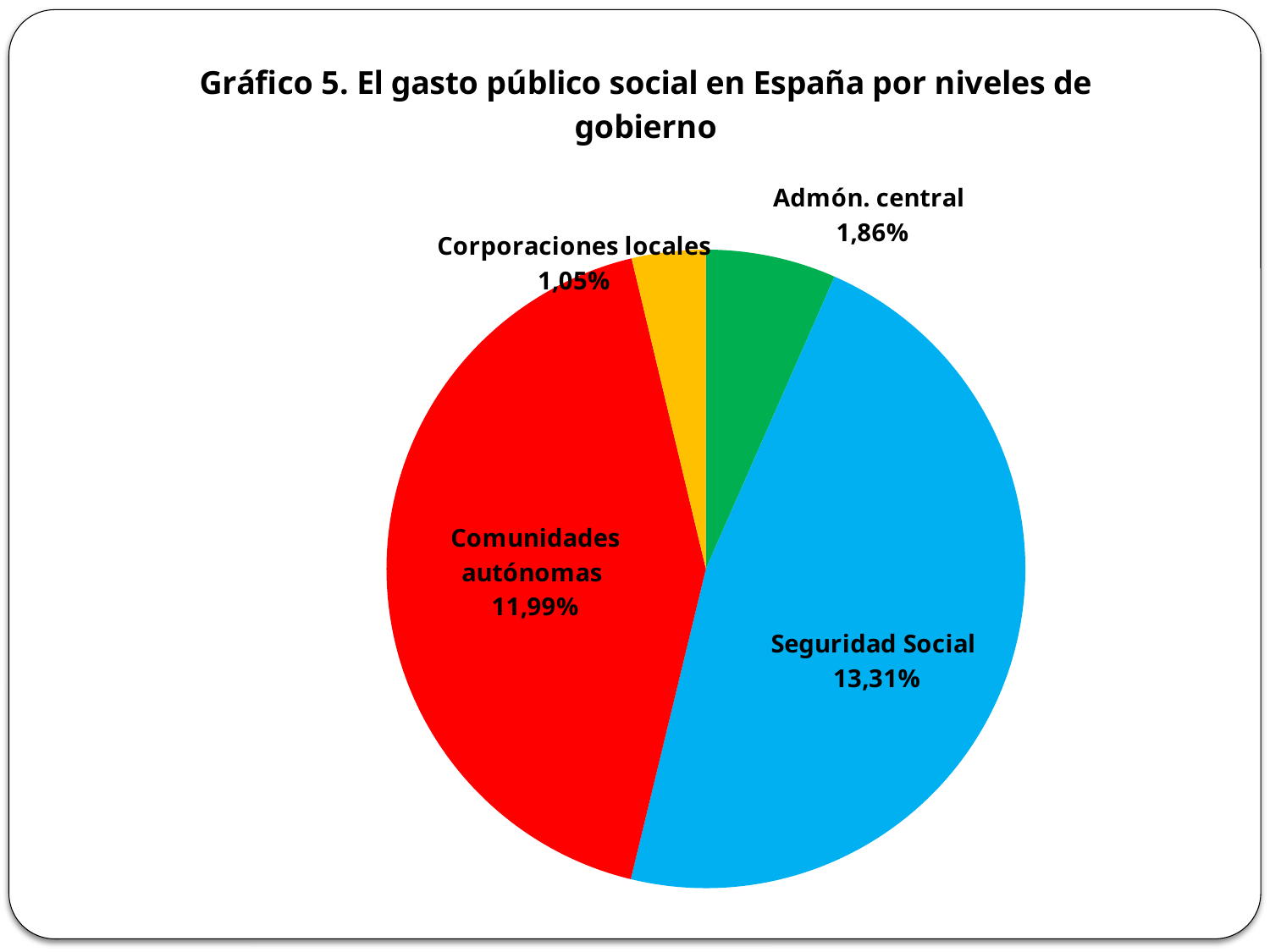
What is the difference between the values for Admón. central and Corporaciones locales? 0,81% How many slices does the pie chart have? 4 Which is larger, the value for Admón. central or the value for Corporaciones locales? Admón. central What value is shown for Comunidades autónomas? 11,99% What value is shown for Seguridad Social? 13,31% What value is shown for Admón. central? 1,86% Which level of government has the smallest slice of the pie? Corporaciones locales What value is shown for Corporaciones locales? 1,05% What kind of chart is shown on the slide? Pie chart What is the difference between the values for Seguridad Social and Comunidades autónomas? 1,32% What is the title of the chart? Gráfico 5. El gasto público social en España por niveles de gobierno Which level of government has the largest slice of the pie? Seguridad Social